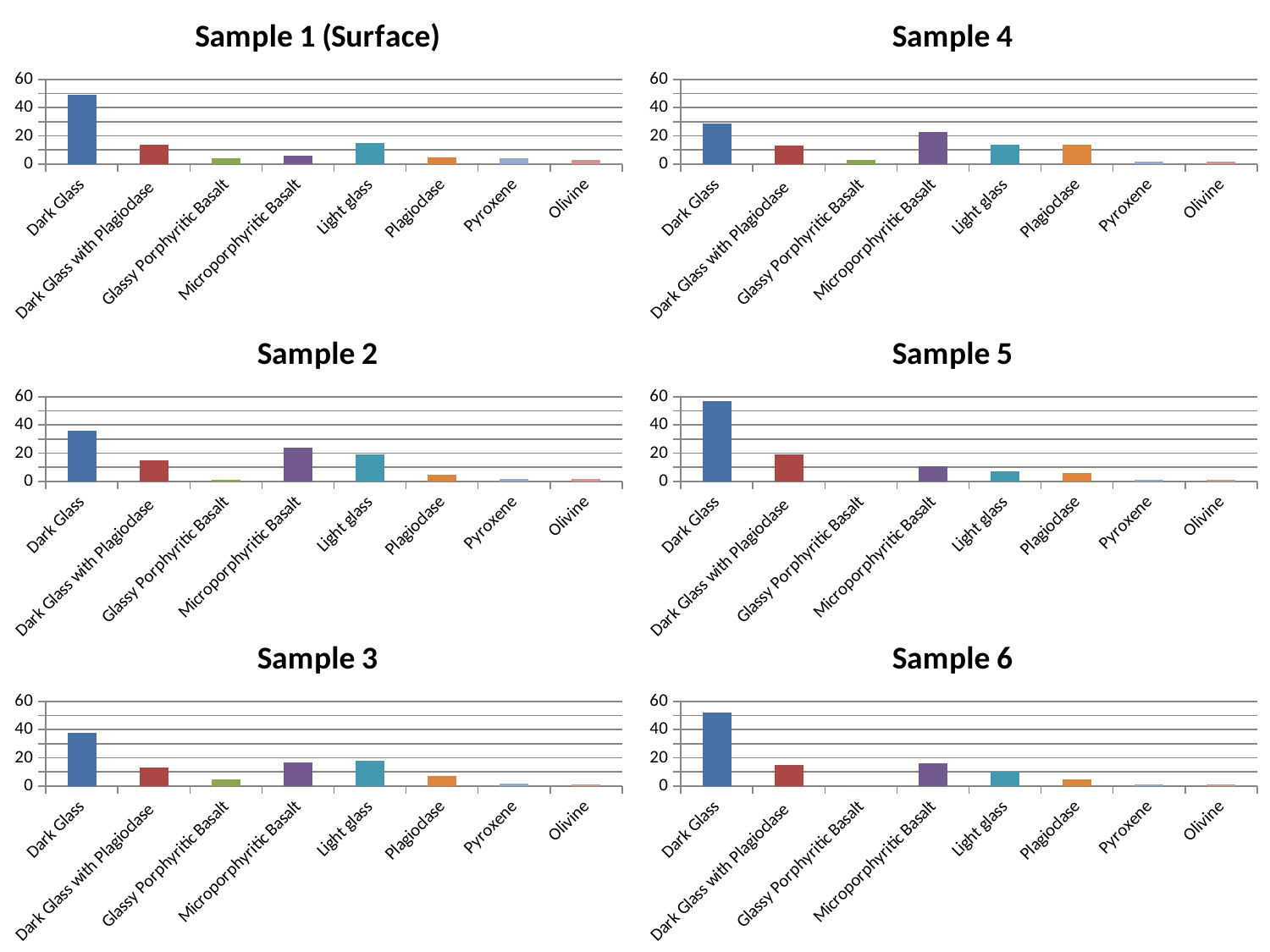
In the Sample 5 chart, is the value for Dark Glass greater or less than 50? greater In the Sample 2 chart, which is larger, Microporphyritic Basalt or Light glass? Microporphyritic Basalt In the Sample 4 chart, which is larger, Dark Glass or Microporphyritic Basalt? Dark Glass In the Sample 6 chart, which is larger, Microporphyritic Basalt or Light glass? Microporphyritic Basalt What kind of chart is the Sample 3 chart? bar chart How many categories are shown on the x axis of the Sample 6 chart? 8 In the Sample 3 chart, is the value for Dark Glass greater or less than 30? greater In the Sample 1 (Surface) chart, which category has the highest value? Dark Glass In the Sample 4 chart, is the value for Dark Glass greater or less than 20? greater In the Sample 2 chart, which category has the highest value? Dark Glass